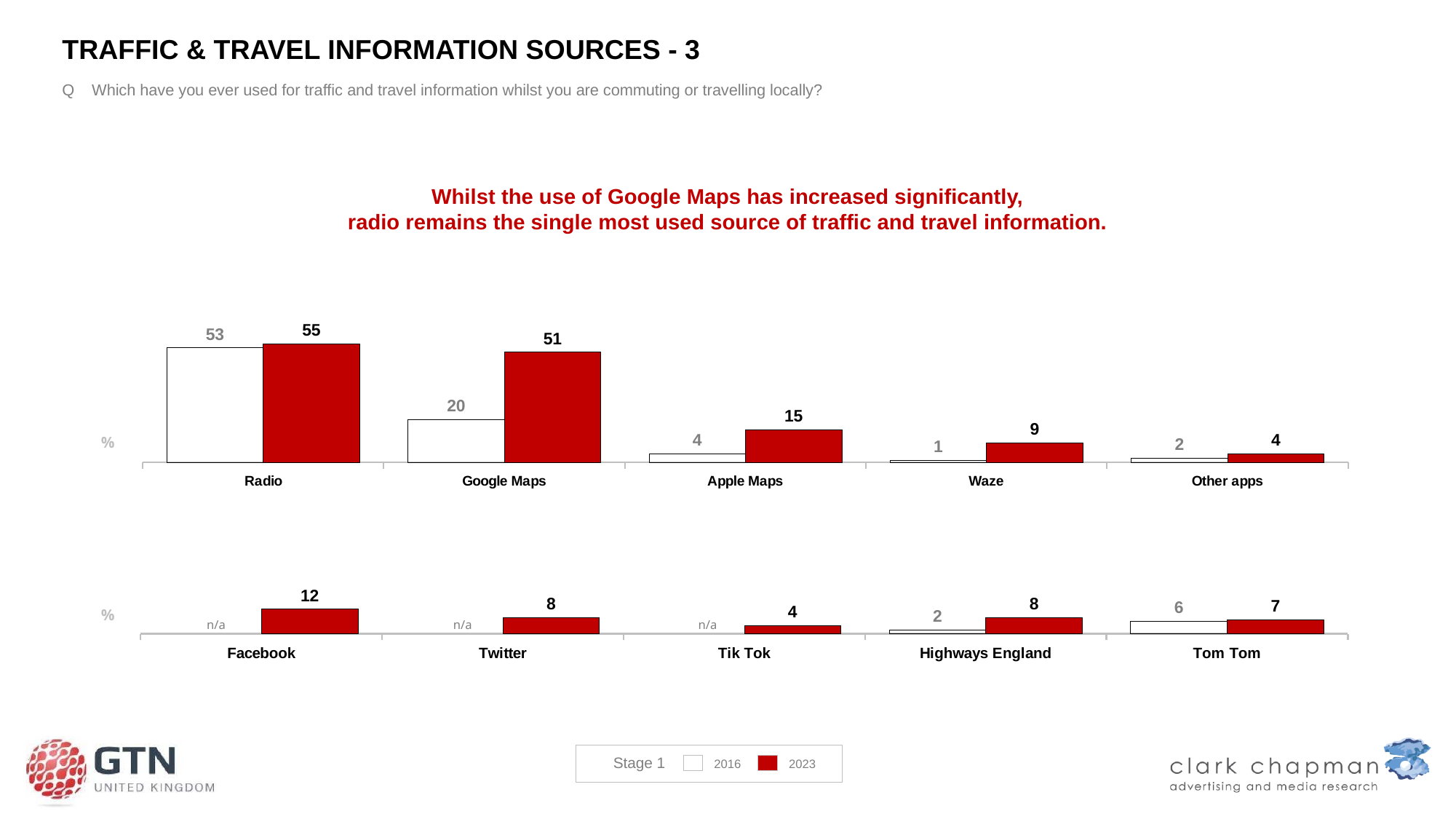
In the top chart, what is the 2023 value for Radio? 55 In the top chart, which category has the lowest 2016 value? Waze What type of chart is the top chart? Bar chart How many categories are shown in the bottom chart? 5 In the top chart, what is the 2016 value for Google Maps? 20 In the bottom chart, what is the 2016 value for Tom Tom? 6 In the top chart, which category has the highest 2023 value? Radio How many series does the legend list? 2 In the top chart, what is the difference between the 2023 and 2016 values for Google Maps? 31 In the bottom chart, which categories show n/a for 2016? Facebook, Twitter, Tik Tok In the bottom chart, what is the 2023 value for Facebook? 12 In the bottom chart, which is larger: the 2023 value for Twitter or the 2023 value for Tik Tok? Twitter